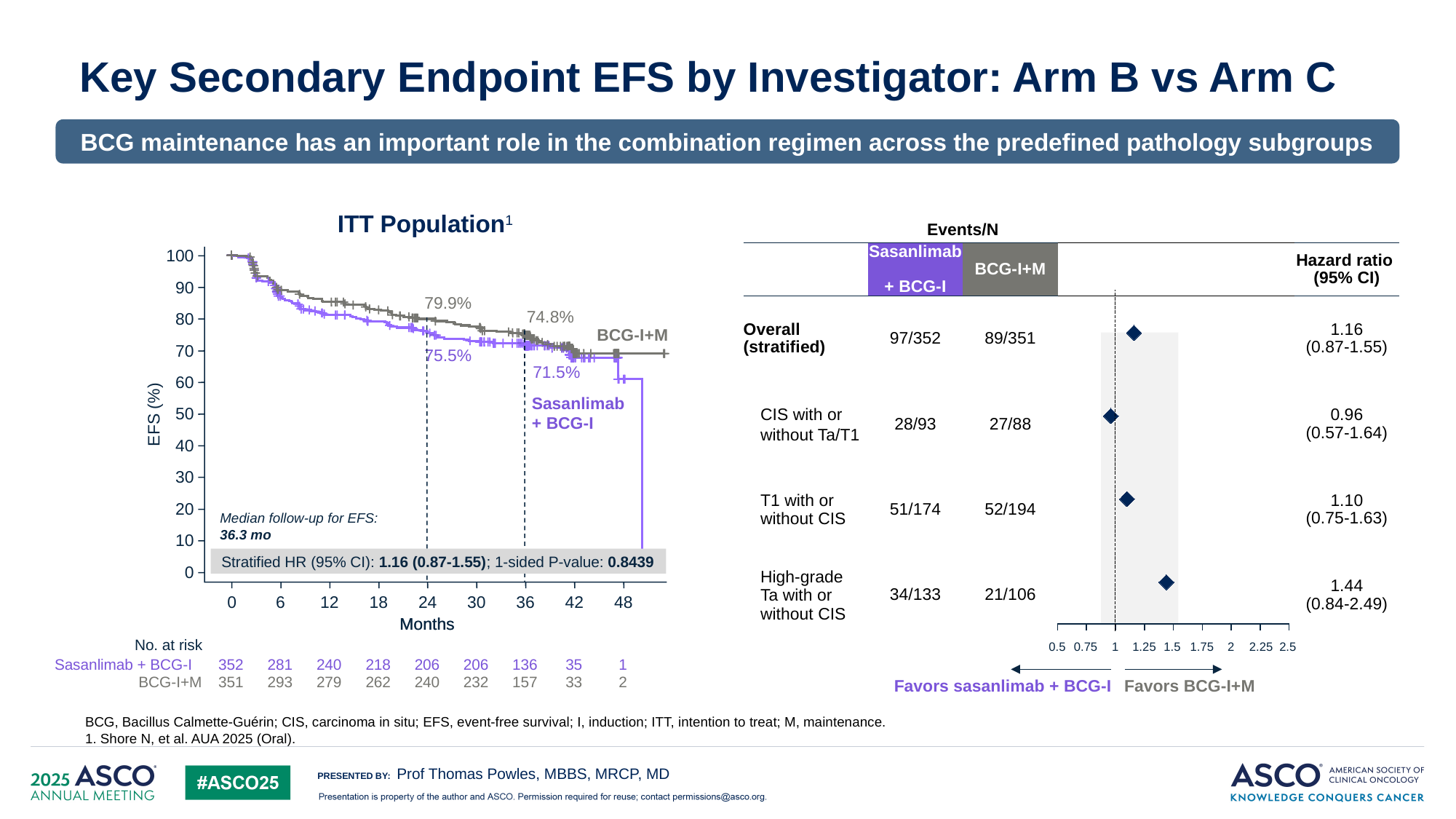
In the ITT Population chart, what is the 1-sided P-value? 0.8439 In the ITT Population chart, what is the stratified HR (95% CI)? 1.16 (0.87-1.55) In the forest plot on the right, what is the Events/N for Sasanlimab + BCG-I in the Overall (stratified) row? 97/352 In the ITT Population chart, what is the EFS rate for BCG-I+M at 24 months? 79.9% In the forest plot on the right, which row has the highest hazard ratio? High-grade Ta with or without CIS In the ITT Population chart, what is the EFS rate for Sasanlimab + BCG-I at 36 months? 71.5% In the forest plot on the right, which row has the lowest hazard ratio? CIS with or without Ta/T1 In the forest plot on the right, what is the hazard ratio (95% CI) for the High-grade Ta with or without CIS subgroup? 1.44 (0.84-2.49) In the ITT Population chart, what is the difference between the BCG-I+M and Sasanlimab + BCG-I EFS rates at 24 months? 4.4 percentage points In the ITT Population chart, what is the median follow-up for EFS? 36.3 mo In the ITT Population chart, which arm has the higher EFS rate at 36 months? BCG-I+M In the ITT Population chart, how many Sasanlimab + BCG-I patients were at risk at 12 months? 240